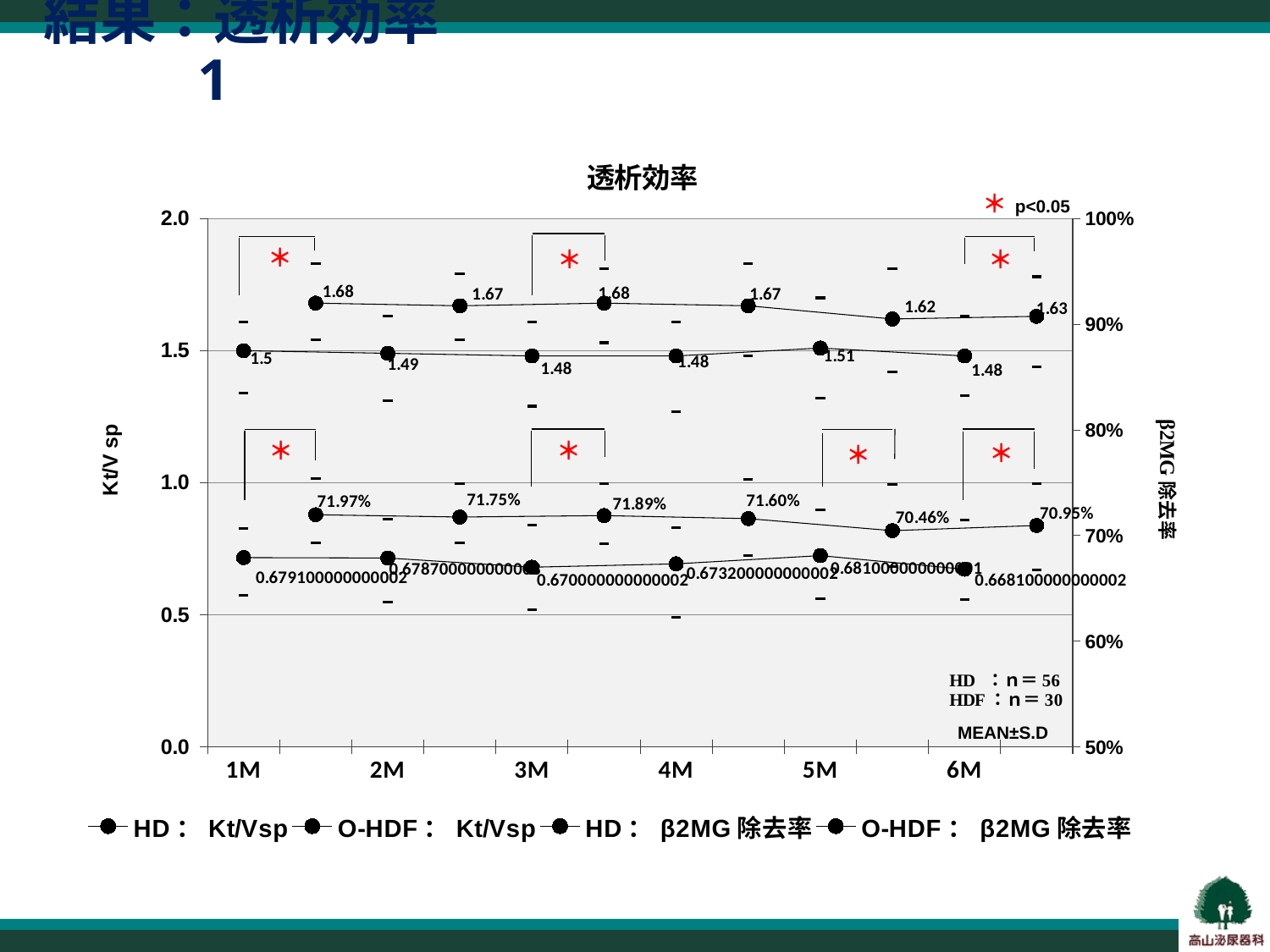
How many time points are shown on the x axis? 6 What is the difference between the O-HDF Kt/Vsp and HD Kt/Vsp values at 3M? 0.20 What is the HD Kt/Vsp value at 5M? 1.51 How many series does the legend list? 4 Which is larger at 6M, the O-HDF Kt/Vsp value or the HD Kt/Vsp value? O-HDF Kt/Vsp What is the O-HDF Kt/Vsp value at 1M? 1.68 What is the title of the chart? 透析効率 What type of chart is shown on the slide? line chart What is the O-HDF β2MG 除去率 value at 1M? 71.97% At which time point is the O-HDF β2MG 除去率 lowest? 5M Is the HD β2MG 除去率 value at 3M greater or less than 70%? less What is the O-HDF β2MG 除去率 value at 5M? 70.46%